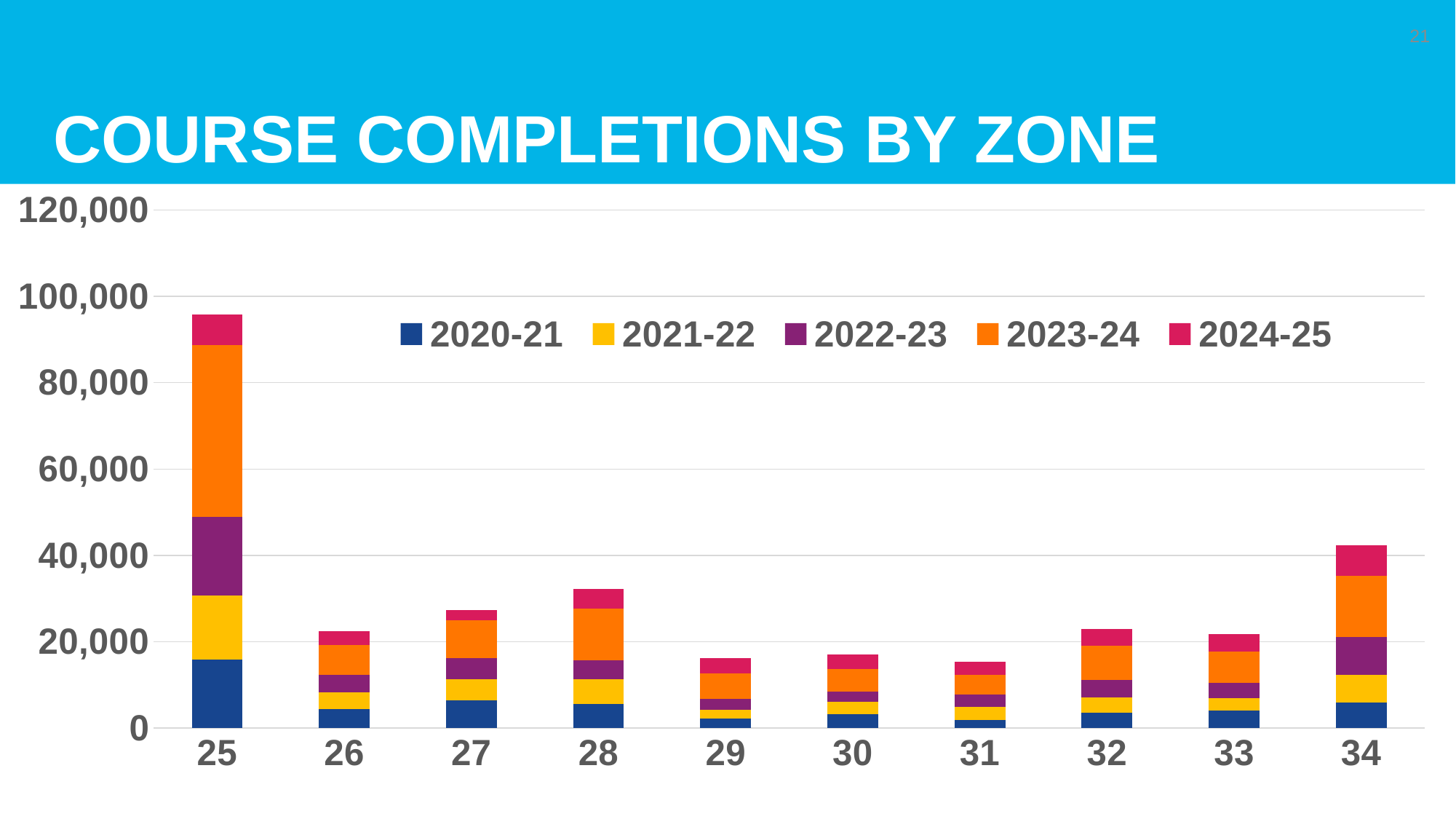
How many series does the legend list? 5 Is the total for zone 28 greater or less than 20,000? greater Is the total for zone 26 greater or less than 40,000? less How many zones (categories) are shown on the x axis? 10 What kind of chart is shown on the slide? Stacked bar chart Is the total for zone 25 greater or less than 80,000? greater Which zone has the highest total course completions? 25 Which series is shown in orange in the legend? 2023-24 Which zone has the larger total, zone 25 or zone 34? 25 What is the title of the chart? COURSE COMPLETIONS BY ZONE Which zone has the larger total, zone 34 or zone 28? 34